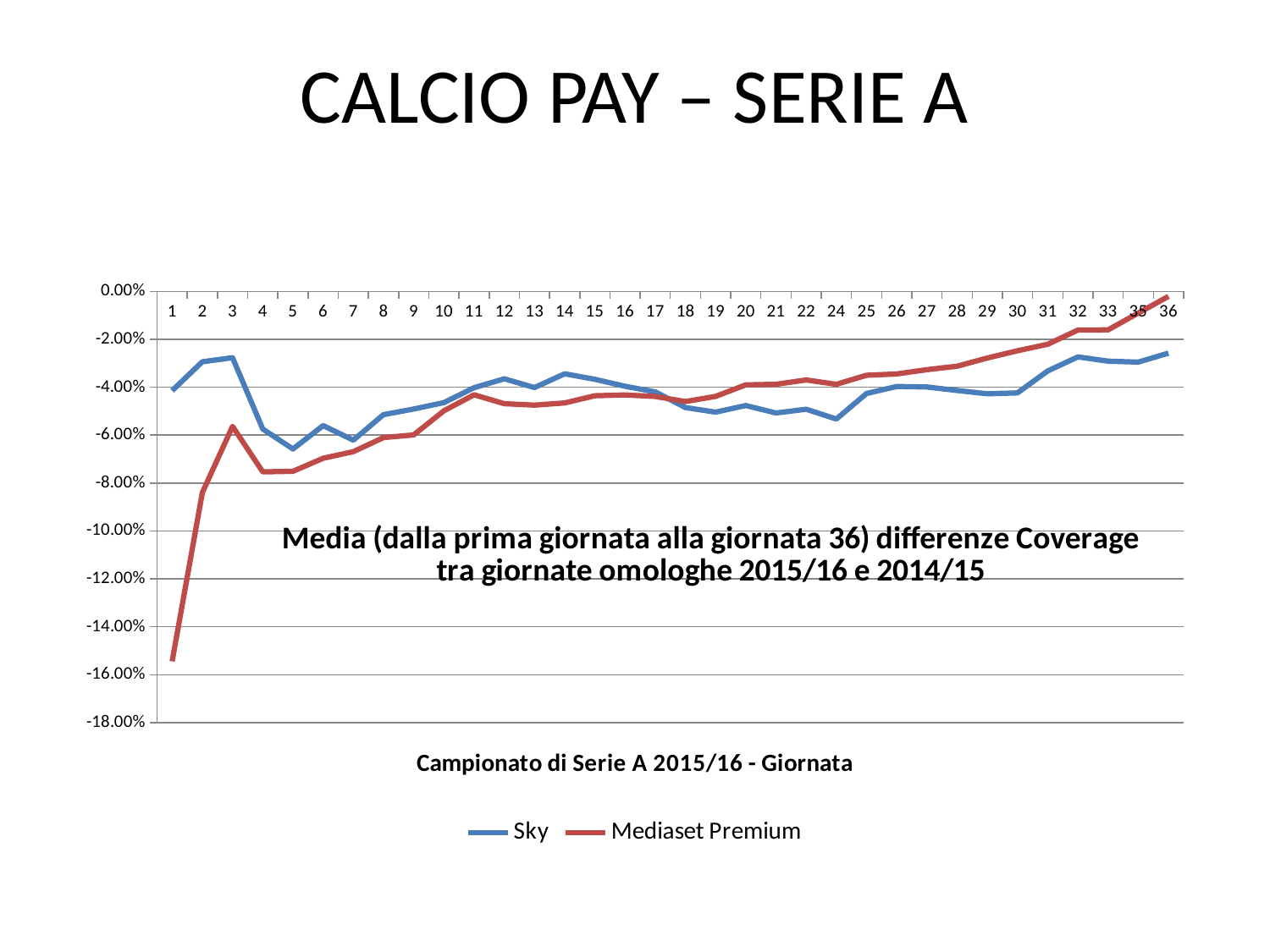
At giornata 36, which series has the higher value, Sky or Mediaset Premium? Mediaset Premium What is the title of the x axis? Campionato di Serie A 2015/16 - Giornata At which giornata does the Sky line reach its lowest value? 5 Is the value for Mediaset Premium at giornata 4 greater or less than -6.00%? less Is the value for Mediaset Premium at giornata 1 greater or less than -14.00%? less How many series does the legend list? 2 At giornata 1, which series has the higher value, Sky or Mediaset Premium? Sky Which series are listed in the legend? Sky and Mediaset Premium At which giornata does the Mediaset Premium line reach its lowest value? 1 What kind of chart is shown on the slide? line chart At which giornata does the Mediaset Premium line reach its highest value? 36 Is the value for Sky at giornata 3 greater or less than -4.00%? greater